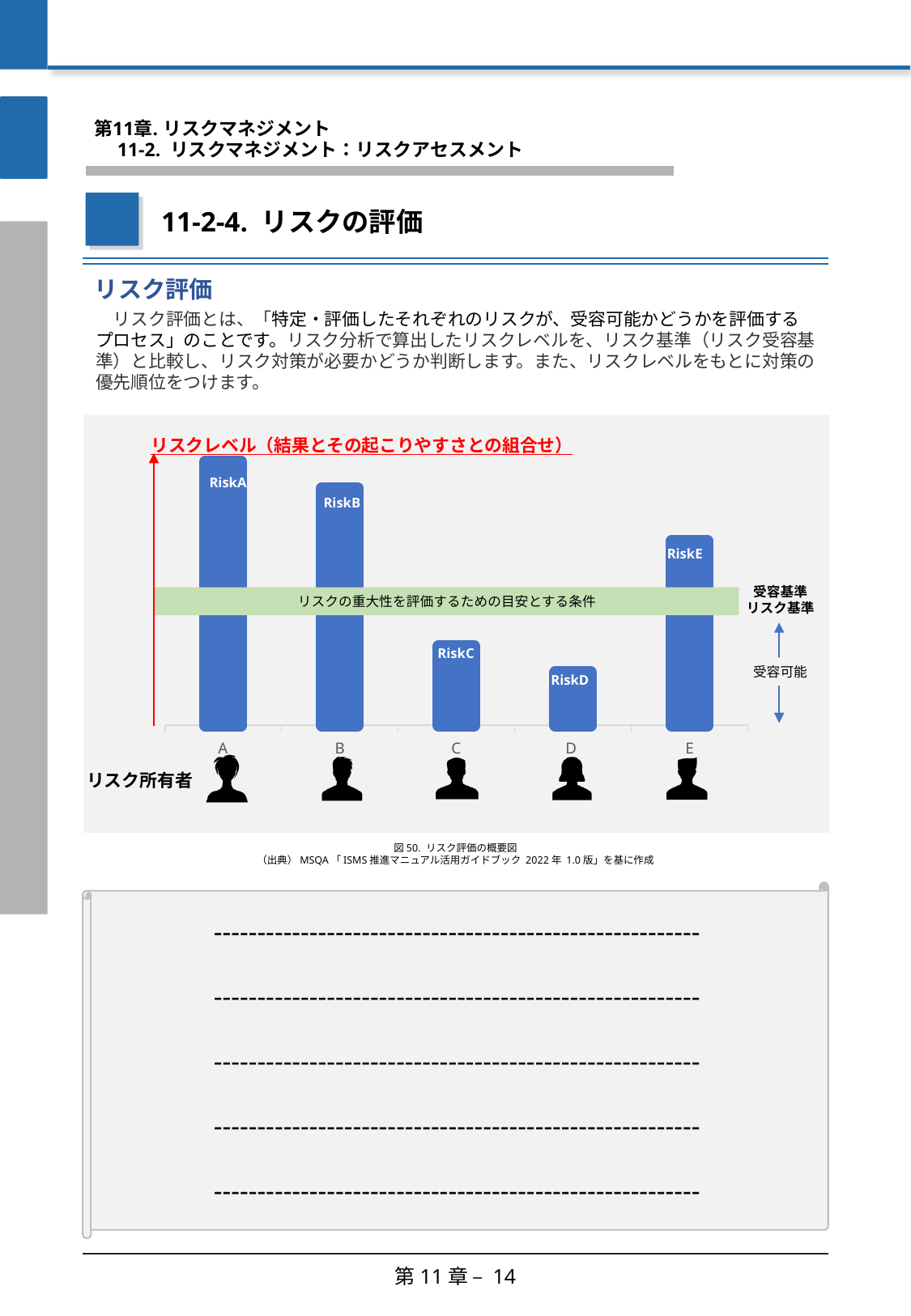
Do the bar heights rise or fall from category A to category D? fall Which has the higher risk level, RiskB or RiskC? RiskB How many bars extend above the green acceptance-criteria band? 3 How many risk bars are plotted in the chart? 5 Which has the higher risk level, RiskA or RiskE? RiskA What kind of chart is shown in the figure? bar chart Which risk has the lowest risk level in the chart? RiskD What label is written on the vertical axis of the chart? リスクレベル（結果とその起こりやすさとの組合せ） What are the category labels on the x axis of the chart? A, B, C, D, E Which has the higher risk level, RiskE or RiskC? RiskE Which risk has the highest risk level in the chart? RiskA